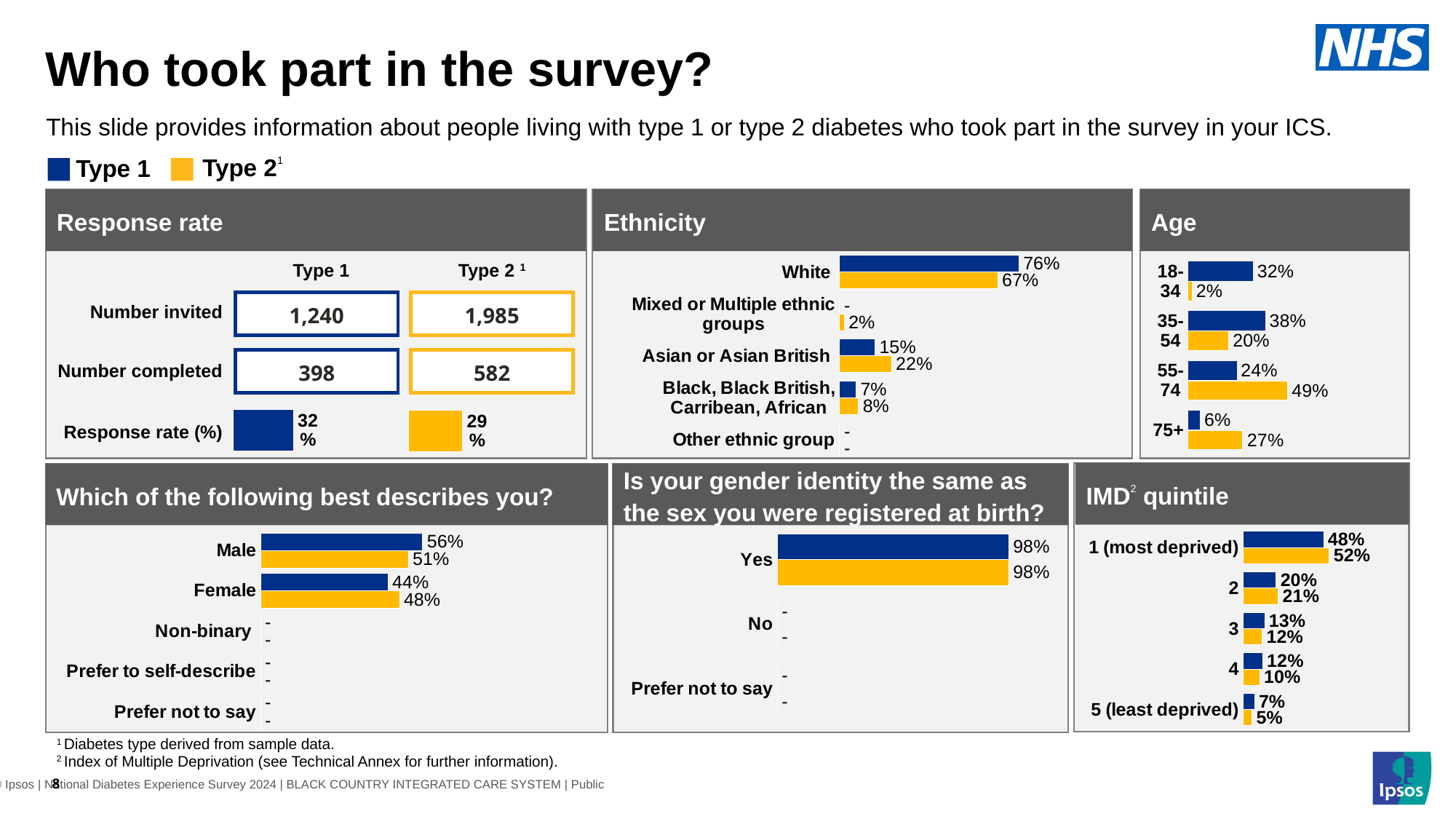
How many series does the legend at the top of the slide list? 2 In the IMD quintile chart, what is the Type 2 value for 1 (most deprived)? 52% In the Ethnicity chart, what is the Type 1 value for White? 76% In the IMD quintile chart, what is the difference between the Type 1 and Type 2 values for quintile 3? 1% In the Age chart, which age group has the lowest Type 1 value? 75+ In the Response rate chart, what is the Type 1 response rate? 32% In the 'Which of the following best describes you?' chart, is the Type 1 value for Male larger or smaller than the Type 2 value for Male? larger In the 'Which of the following best describes you?' chart, what is the Type 2 value for Female? 48% In the Age chart, which age group has the highest Type 2 value? 55-74 In the IMD quintile chart, do the Type 1 values rise or fall from quintile 1 (most deprived) to quintile 5 (least deprived)? fall In the Ethnicity chart, what is the Type 2 value for Asian or Asian British? 22% In the Age chart, what is the difference between the Type 2 and Type 1 values for 75+? 21%